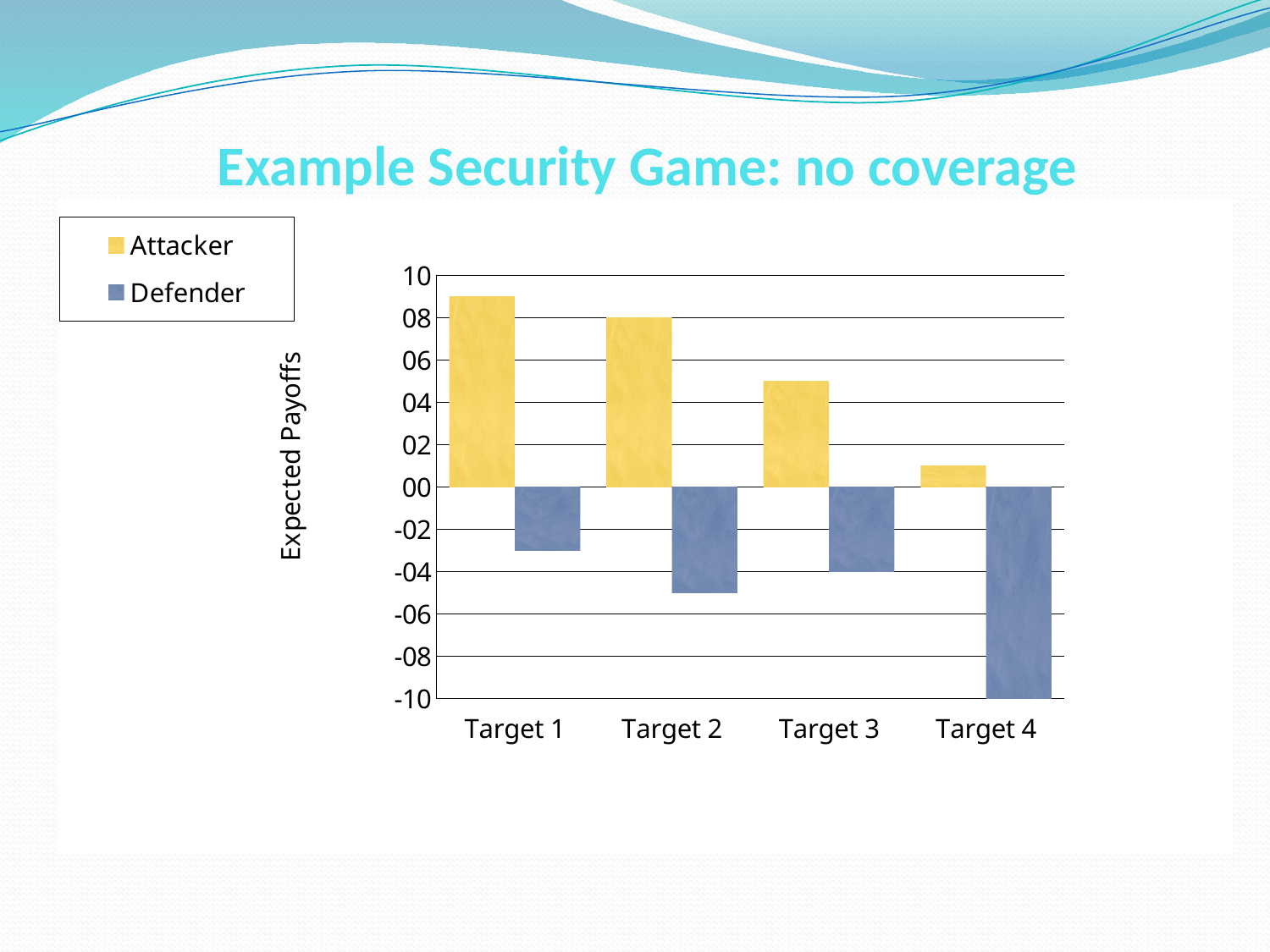
How many targets are shown on the x axis? 4 Is the Attacker value for Target 1 greater or less than 08? greater What is the Attacker value for Target 2? 08 What kind of chart is shown on the slide? bar chart Is the Defender value for Target 2 greater or less than -04? less What is the Defender value for Target 3? -04 What is the label on the vertical axis? Expected Payoffs Do the Attacker values rise or fall from Target 1 to Target 4? fall Which target has the highest Attacker payoff? Target 1 What is the Defender value for Target 4? -10 Which target has the lowest Defender payoff? Target 4 How many series does the legend list? 2